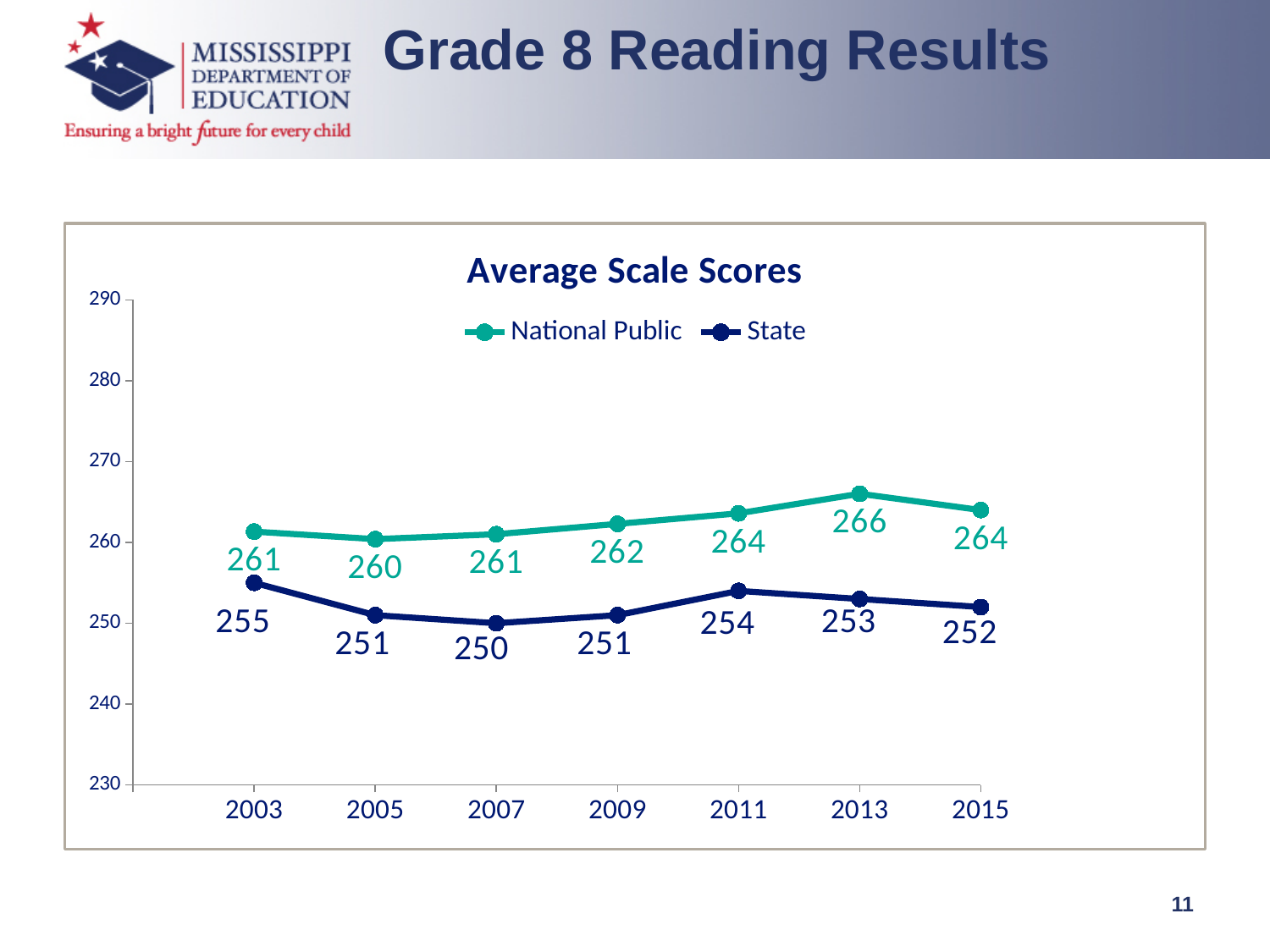
Does the National Public score rise or fall from 2005 to 2013? Rise In which year is the State score lowest? 2007 What is the title of the chart? Average Scale Scores What is the difference between the National Public and State scores in 2011? 10 What kind of chart is shown? Line chart How many series does the legend list? 2 Which is larger, the State score in 2003 or the State score in 2015? 2003 How many years are shown on the x axis? 7 What is the National Public average scale score in 2013? 266 What is the State average scale score in 2007? 250 What is the State average scale score in 2015? 252 In which year is the National Public score highest? 2013